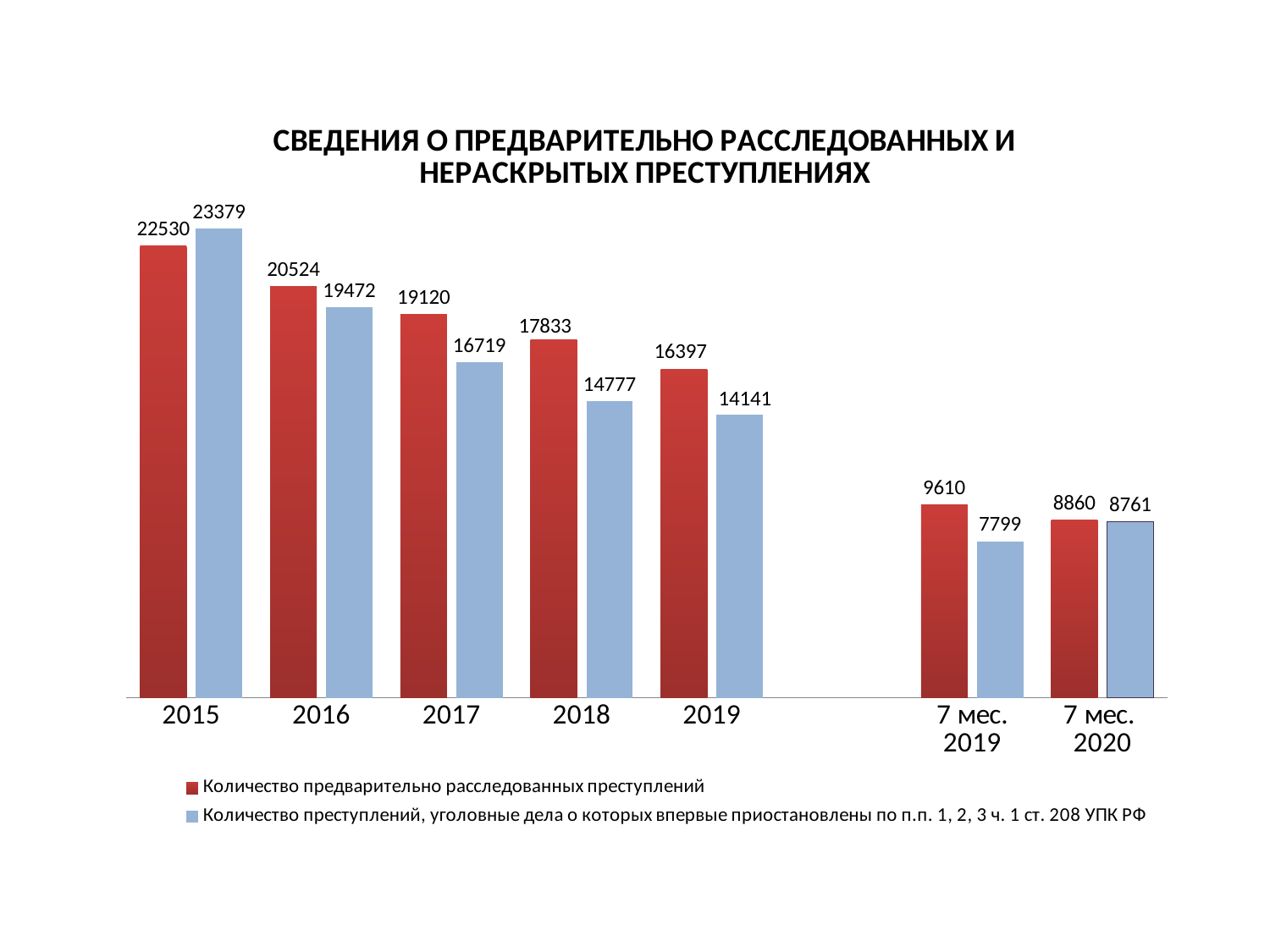
What is the difference between the two series' values for 2015? 849 For 2015, which series has the larger value? Количество преступлений, уголовные дела о которых впервые приостановлены по п.п. 1, 2, 3 ч. 1 ст. 208 УПК РФ What is the value of 'Количество предварительно расследованных преступлений' for '7 мес. 2020'? 8860 What kind of chart is shown on the slide? bar chart In which category is 'Количество преступлений, уголовные дела о которых впервые приостановлены по п.п. 1, 2, 3 ч. 1 ст. 208 УПК РФ' lowest? 7 мес. 2019 How many categories are shown on the x axis? 7 What is the value of 'Количество преступлений, уголовные дела о которых впервые приостановлены по п.п. 1, 2, 3 ч. 1 ст. 208 УПК РФ' for 2018? 14777 In which category is 'Количество предварительно расследованных преступлений' highest? 2015 What is the difference between the two series' values for 2019? 2256 How many series does the legend list? 2 What is the value of 'Количество предварительно расследованных преступлений' for 2017? 19120 Does 'Количество предварительно расследованных преступлений' rise or fall from 2015 to 2019? fall